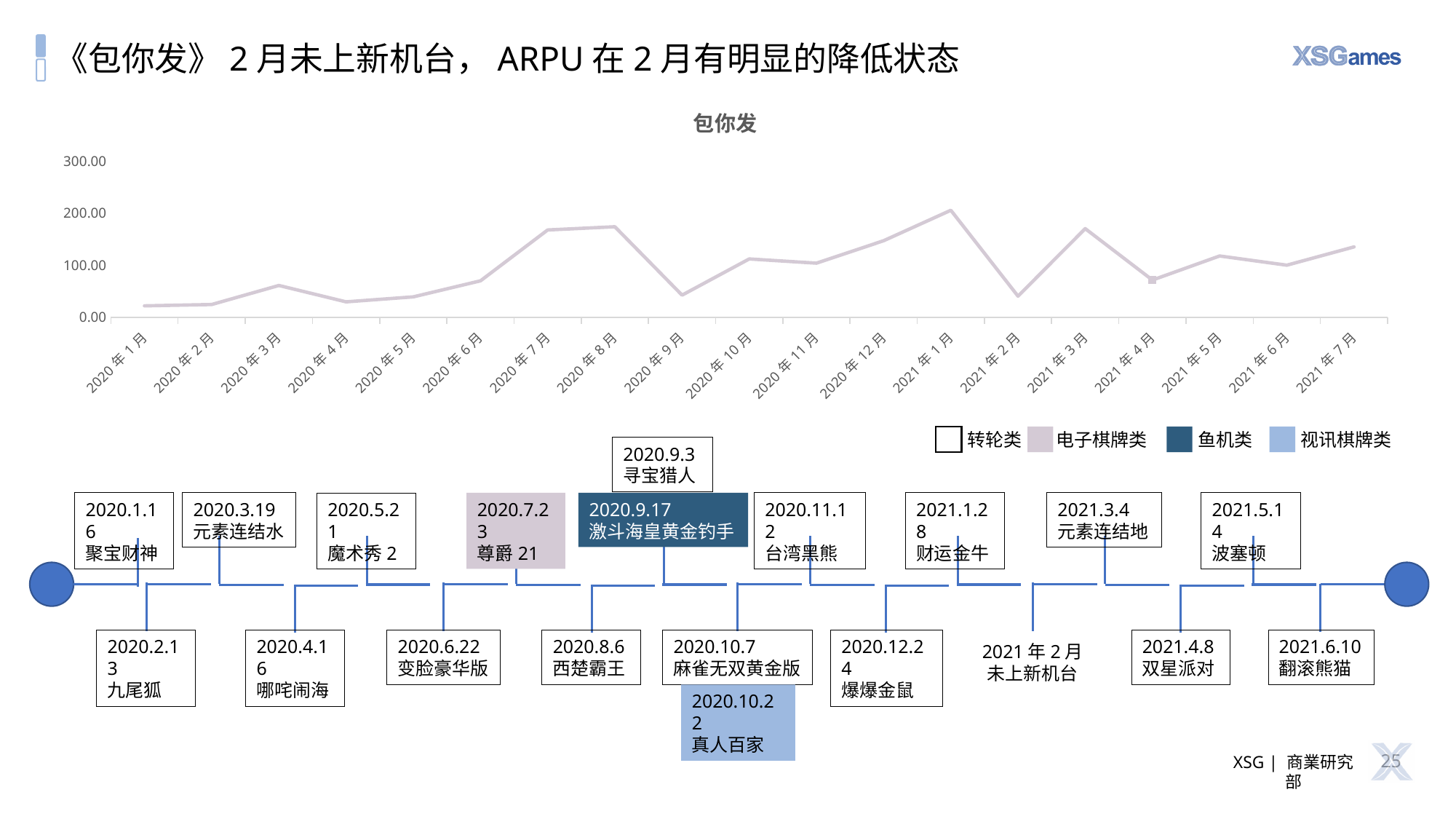
How many monthly data points are plotted on the chart? 19 Is the value for 2020 年 1 月 greater or less than 100? less Is the value for 2021 年 2 月 greater or less than 100? less Which is larger, the value for 2021 年 1 月 or 2021 年 2 月? 2021 年 1 月 Which month has the highest value on the chart? 2021 年 1 月 Which is larger, the value for 2020 年 8 月 or 2020 年 9 月? 2020 年 8 月 Is the value for 2020 年 7 月 greater or less than 100? greater What kind of chart is shown on the slide? line chart What is the title of the chart? 包你发 What is the highest value shown on the y axis? 300.00 Does the line rise or fall from 2021 年 1 月 to 2021 年 2 月? fall